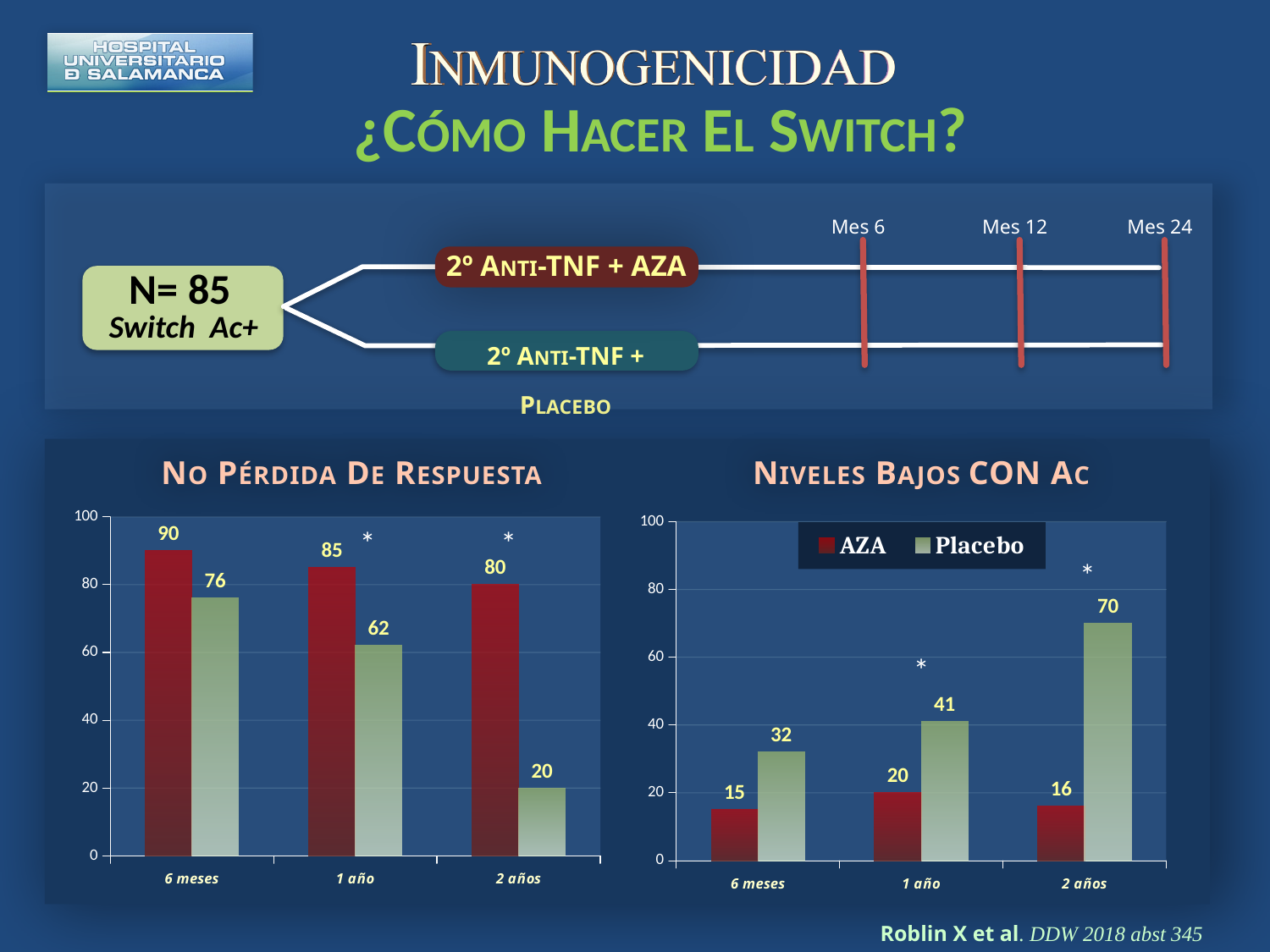
In the 'No Pérdida De Respuesta' chart, how many categories are shown on the x axis? 3 In the 'No Pérdida De Respuesta' chart, what is the value of the green bar at 2 años? 20 In the 'Niveles Bajos CON Ac' chart, what is the AZA value at 6 meses? 15 What type of chart is the 'Niveles Bajos CON Ac' chart? bar chart In the 'Niveles Bajos CON Ac' chart, which category has the highest Placebo value? 2 años In the 'Niveles Bajos CON Ac' chart, which category has the lowest AZA value? 6 meses In the 'No Pérdida De Respuesta' chart, what is the difference between the red and green bars at 1 año? 23 In the 'Niveles Bajos CON Ac' chart, how many series does the legend list? 2 In the 'No Pérdida De Respuesta' chart, what is the value of the red bar at 6 meses? 90 In the 'Niveles Bajos CON Ac' chart, what is the difference between Placebo and AZA at 2 años? 54 In the 'No Pérdida De Respuesta' chart, do the red bars rise or fall from 6 meses to 2 años? fall In the 'Niveles Bajos CON Ac' chart, what is the Placebo value at 2 años? 70